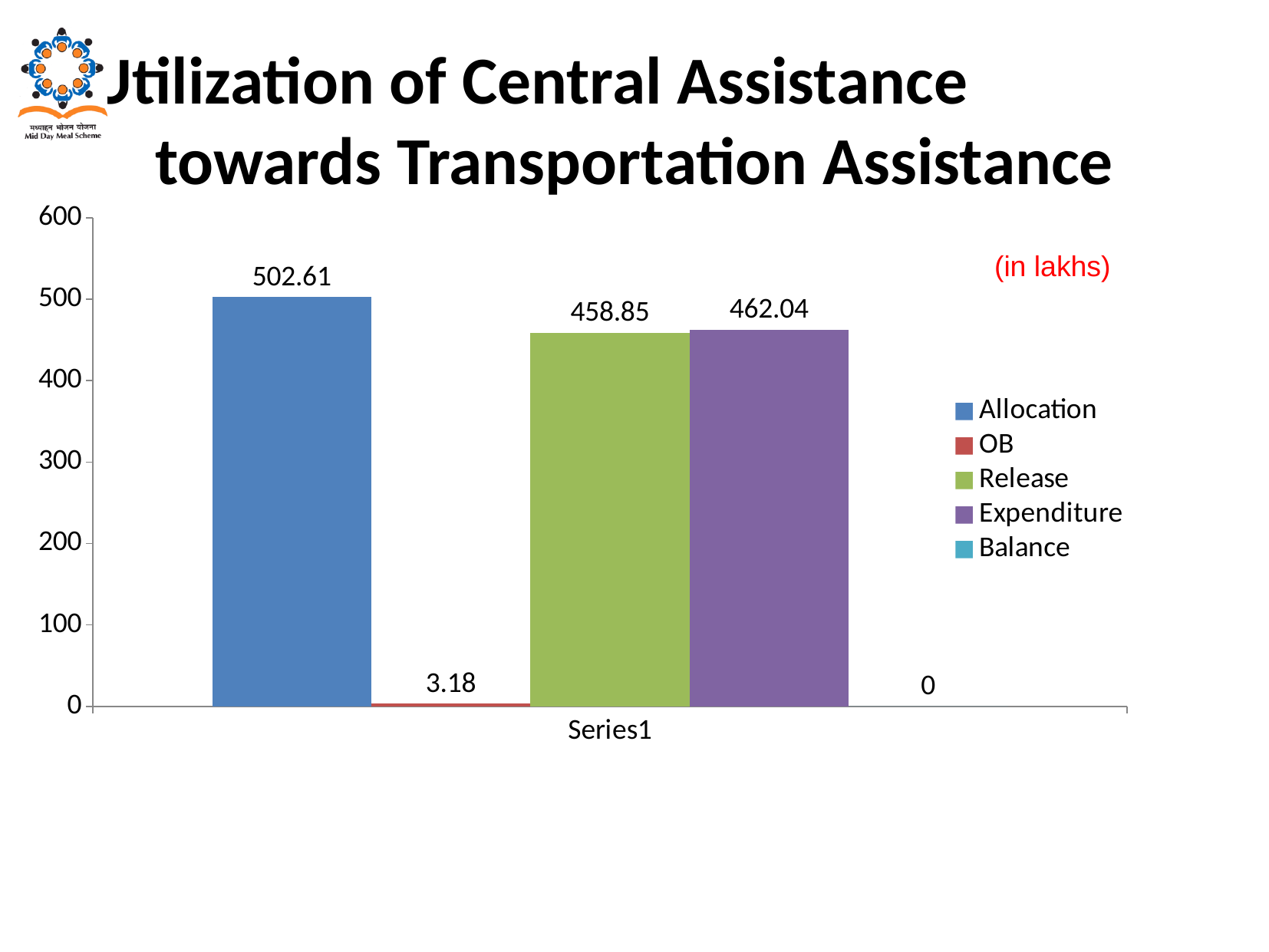
What kind of chart is shown on the slide? Bar chart How many series does the legend list? 5 Which series has the highest value? Allocation Which is larger, Expenditure or Release? Expenditure What is the value for Expenditure? 462.04 What is the value for Allocation? 502.61 What is the difference between Allocation and Release? 43.76 What is the value for Release? 458.85 What is the value for Balance? 0 What is the value for OB? 3.18 In what units are the values on the chart expressed? in lakhs Which series has the lowest value? Balance